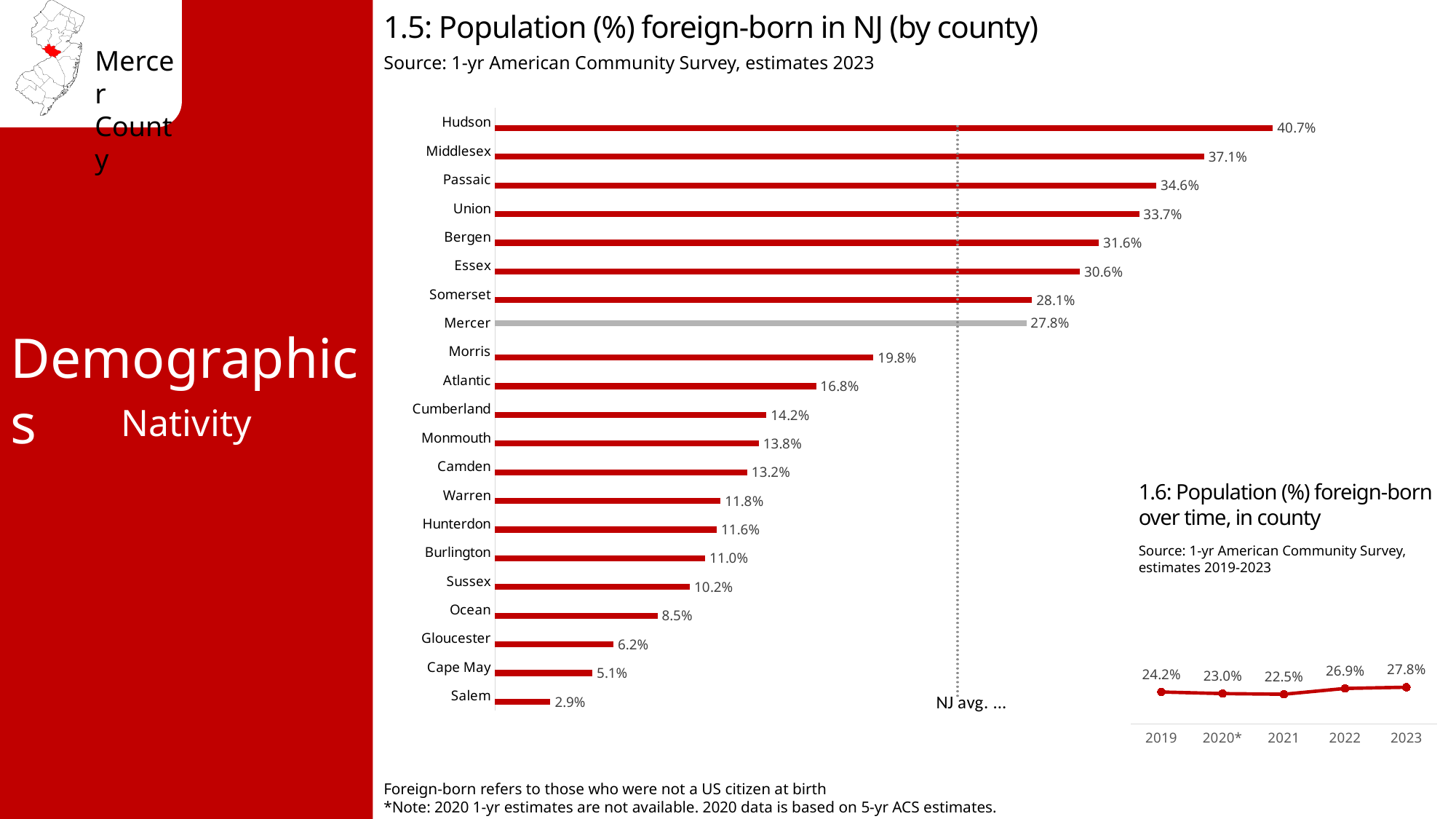
In chart 1.5 (Population (%) foreign-born in NJ by county), what is the value for Mercer? 27.8% In chart 1.6 (Population (%) foreign-born over time, in county), what is the value for 2021? 22.5% In chart 1.5 (Population (%) foreign-born in NJ by county), how many counties are shown? 21 In chart 1.5 (Population (%) foreign-born in NJ by county), which county's bar is shown in grey rather than red? Mercer What kind of chart is chart 1.5 (Population (%) foreign-born in NJ by county)? Bar chart In chart 1.5 (Population (%) foreign-born in NJ by county), what is the value for Passaic? 34.6% In chart 1.6 (Population (%) foreign-born over time, in county), which year has the highest value? 2023 In chart 1.5 (Population (%) foreign-born in NJ by county), which is larger, Bergen or Essex? Bergen In chart 1.5 (Population (%) foreign-born in NJ by county), what is the difference between Hudson and Middlesex? 3.6% In chart 1.5 (Population (%) foreign-born in NJ by county), which county has the highest value? Hudson In chart 1.6 (Population (%) foreign-born over time, in county), what is the difference between 2023 and 2019? 3.6% In chart 1.5 (Population (%) foreign-born in NJ by county), which county has the lowest value? Salem